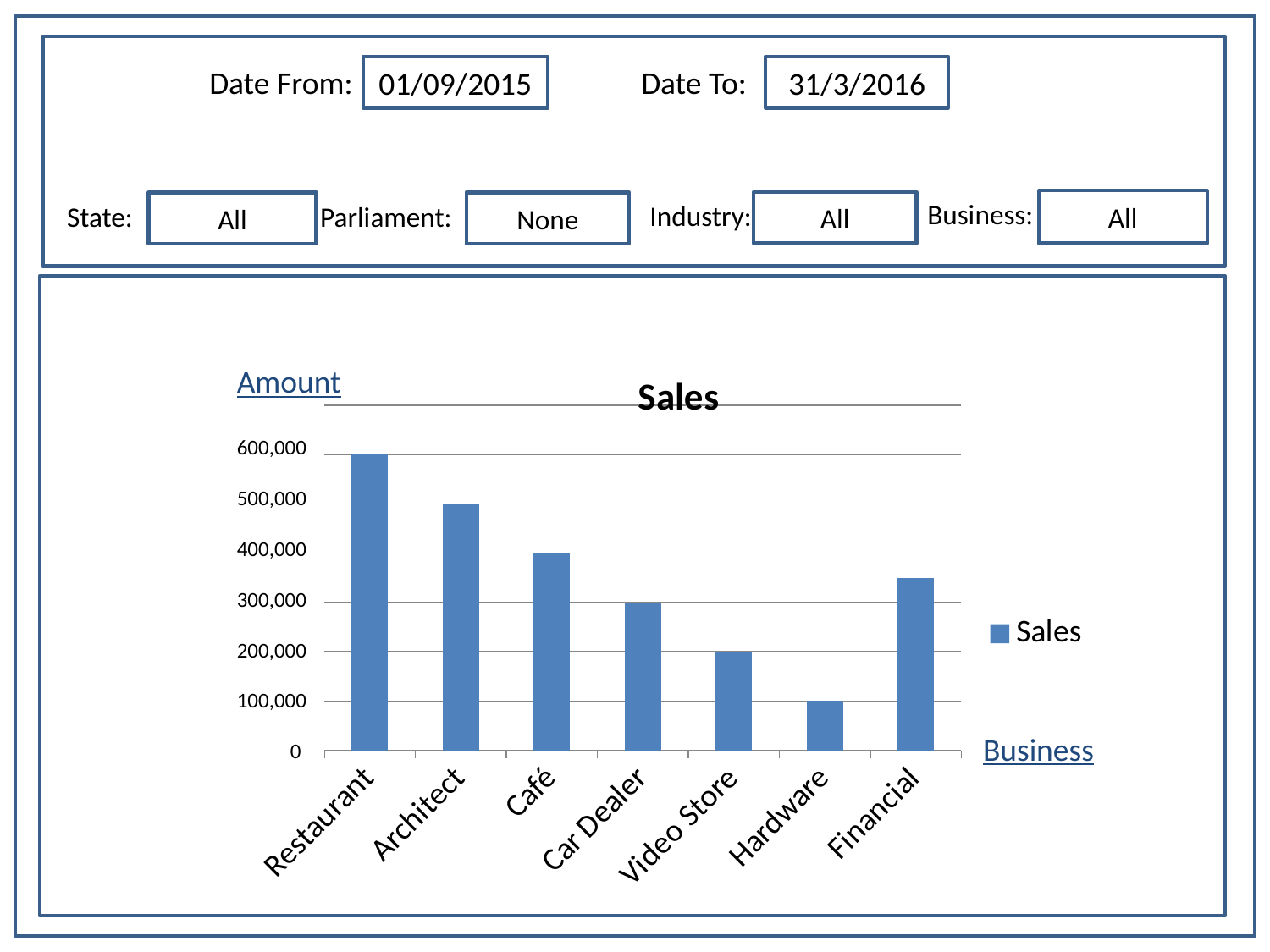
What is the Sales value for Restaurant? 600,000 What type of chart is shown on the slide? Bar chart Which business has the lowest Sales? Hardware How many series does the chart legend list? 1 Which business has the highest Sales? Restaurant What is the Sales value for Café? 400,000 Is the Sales value for Financial greater or less than 300,000? greater Which has higher Sales, Video Store or Financial? Financial What is the difference in Sales between Architect and Car Dealer? 200,000 What is the title of the chart? Sales What is the Sales value for Hardware? 100,000 How many business categories are shown on the x axis of the chart? 7